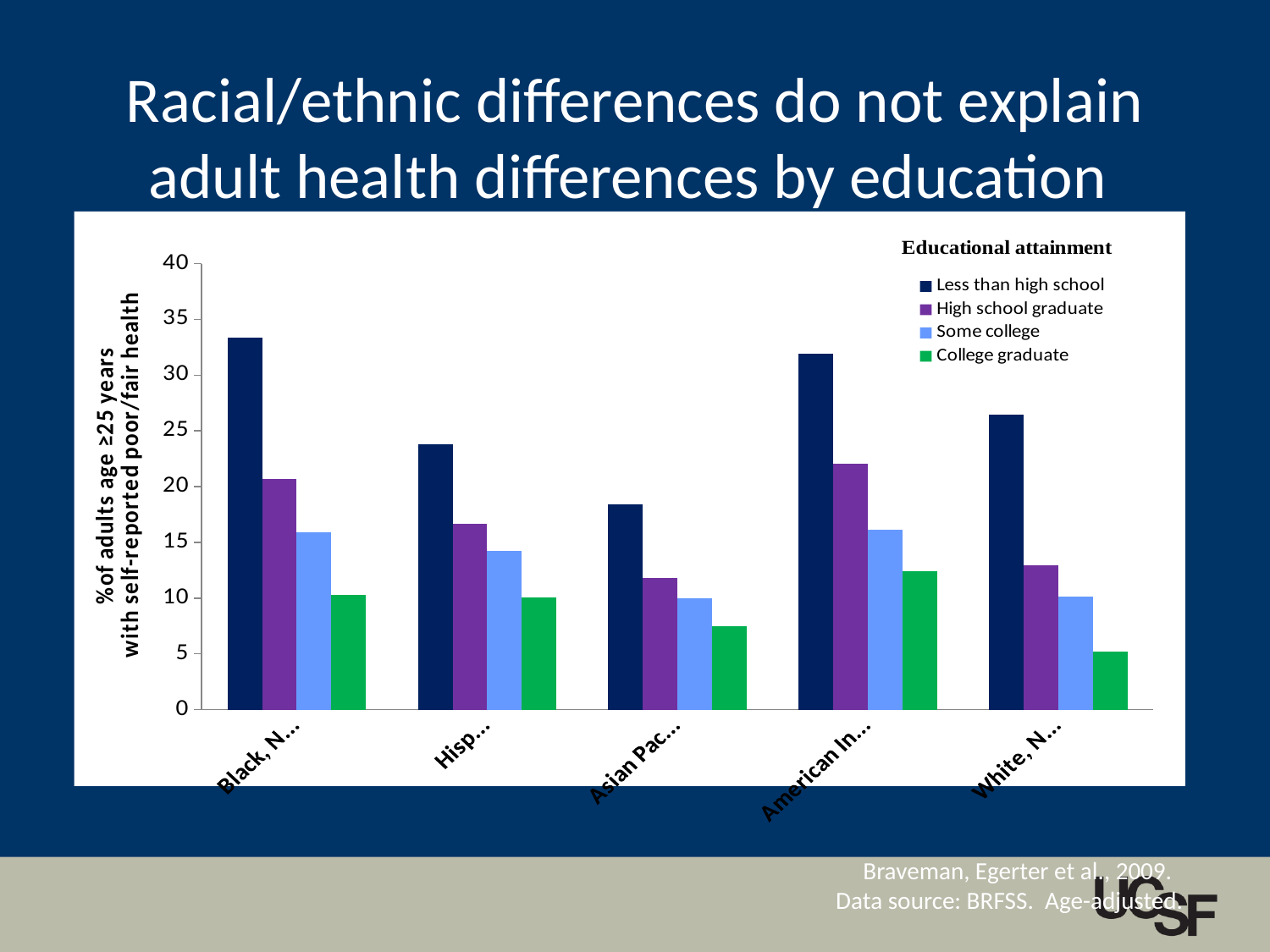
Is the 'College graduate' value for the last group on the right (White, N...) greater or less than 10? less How many racial/ethnic groups (categories) are plotted along the x axis? 5 Which group has the lowest 'Less than high school' bar? Asian Pac... (third group) Which educational attainment series has the lowest bar in every racial/ethnic group? College graduate Is the 'Less than high school' value for the first group from the left (Black, N...) greater or less than 30? greater Within the first group (Black, N...), which is larger: the 'Less than high school' bar or the 'College graduate' bar? Less than high school Is the 'High school graduate' value for the fourth group (American In...) greater or less than 20? greater Which legend entry is shown in green? College graduate Within each racial/ethnic group, do the bars rise or fall going from 'Less than high school' to 'College graduate'? fall How many series does the legend list? 4 What is the title of the legend? Educational attainment What kind of chart is shown on the slide? Bar chart